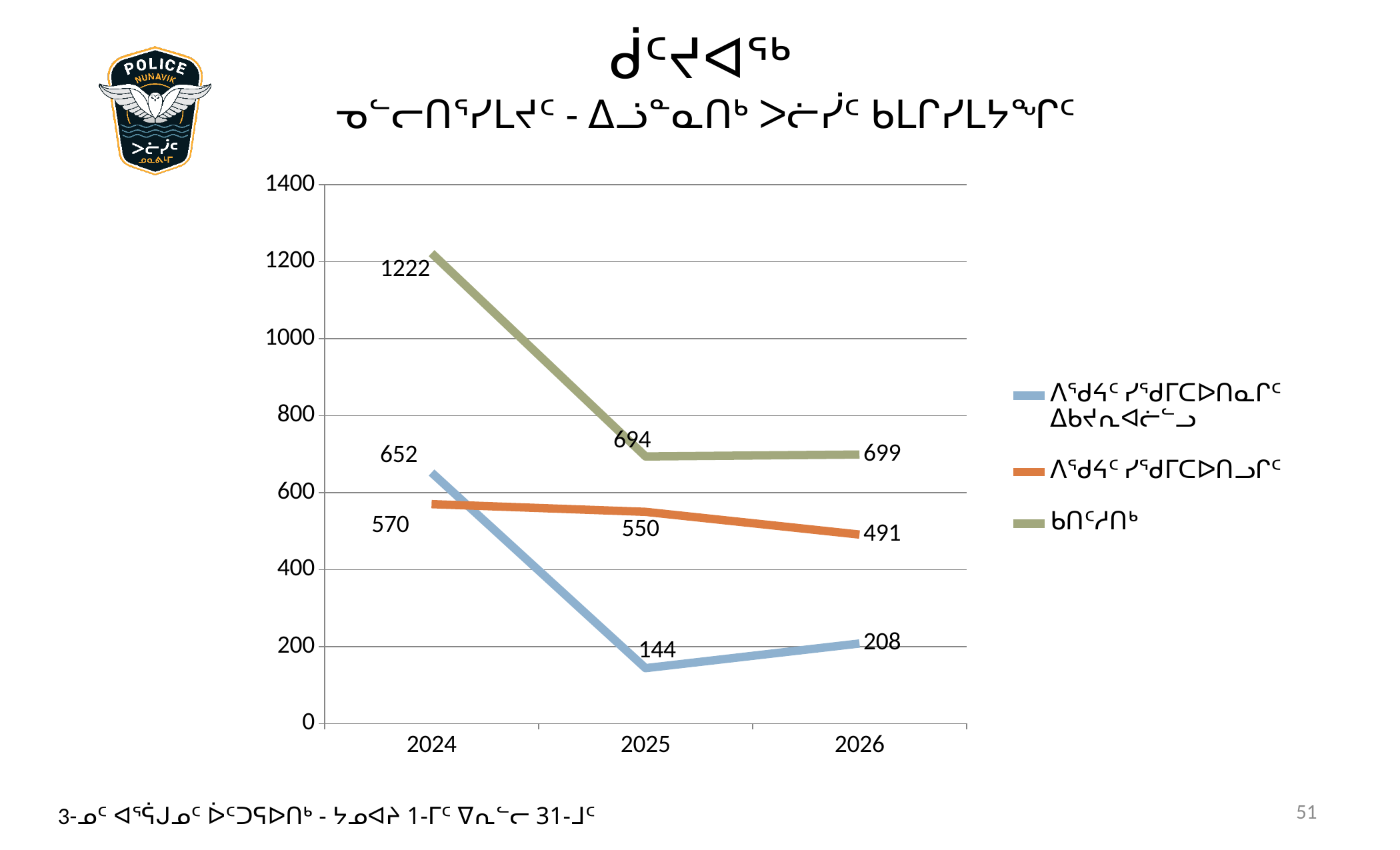
How many years are shown along the x axis? 3 Does the orange line rise or fall from 2024 to 2026? fall What is the value of the blue line in 2025? 144 How many series does the legend list? 3 What is the difference between the blue line's 2026 and 2025 values? 64 In which year does the blue line reach its lowest value? 2025 What kind of chart is shown on the slide? line chart What is the value of the orange line in 2026? 491 By how much did the green line drop from 2024 to 2025? 528 In which year does the green line reach its highest value? 2024 What is the value of the green line in 2024? 1222 In 2026, which is larger: the orange line or the blue line? orange line